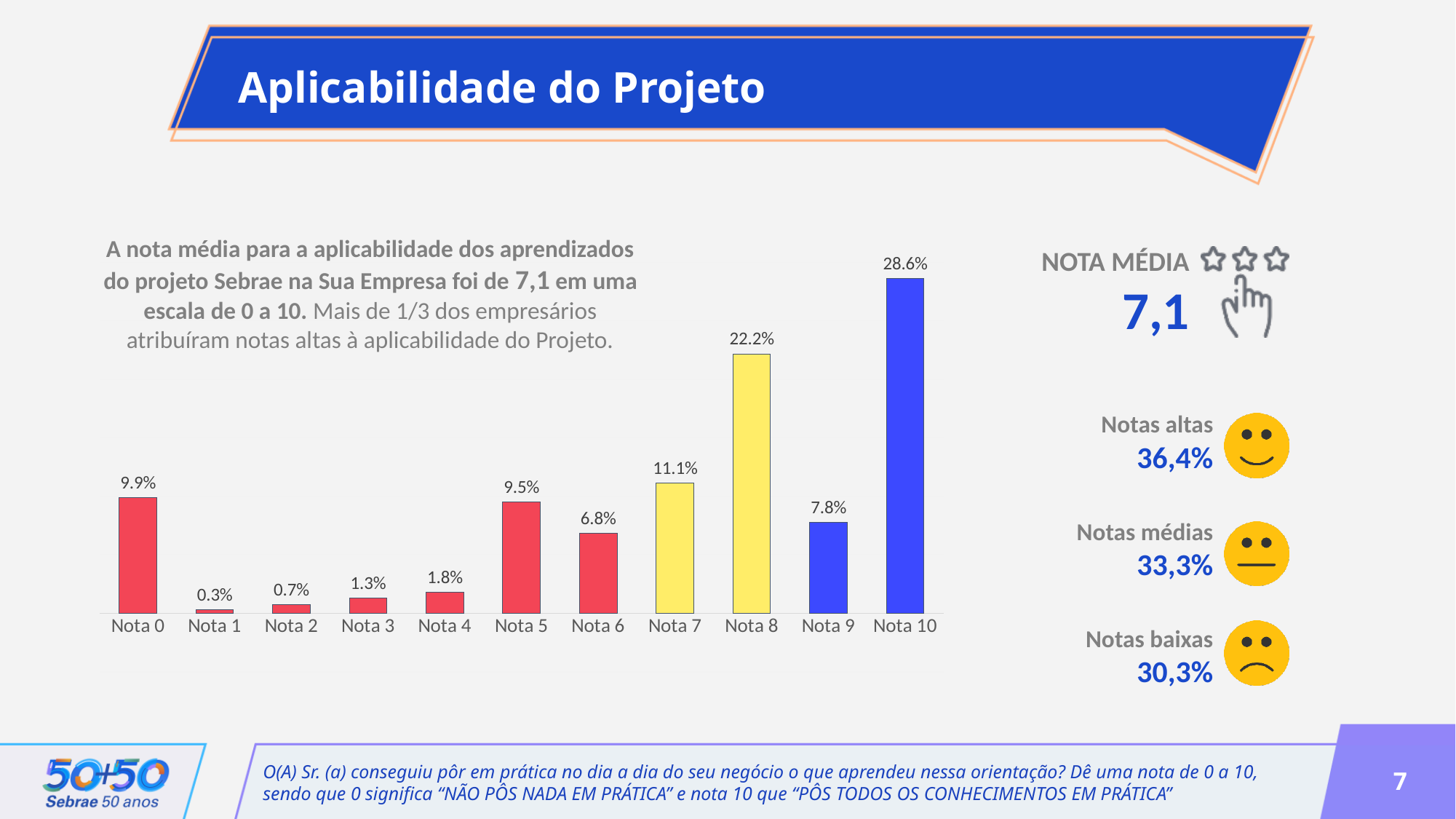
What is the value for Nota 7? 11.1% How many categories are shown on the x axis? 11 Which is larger, the value for Nota 5 or the value for Nota 6? Nota 5 Which category has the lowest value? Nota 1 What colour are the bars for Nota 7 and Nota 8? Yellow What is the difference between the values for Nota 4 and Nota 3? 0.5% What is the total of the values for Nota 9 and Nota 10? 36.4% What is the value for Nota 10? 28.6% What is the value for Nota 0? 9.9% What is the difference between the values for Nota 10 and Nota 8? 6.4% Which category has the highest value? Nota 10 What kind of chart is shown on the slide? Bar chart